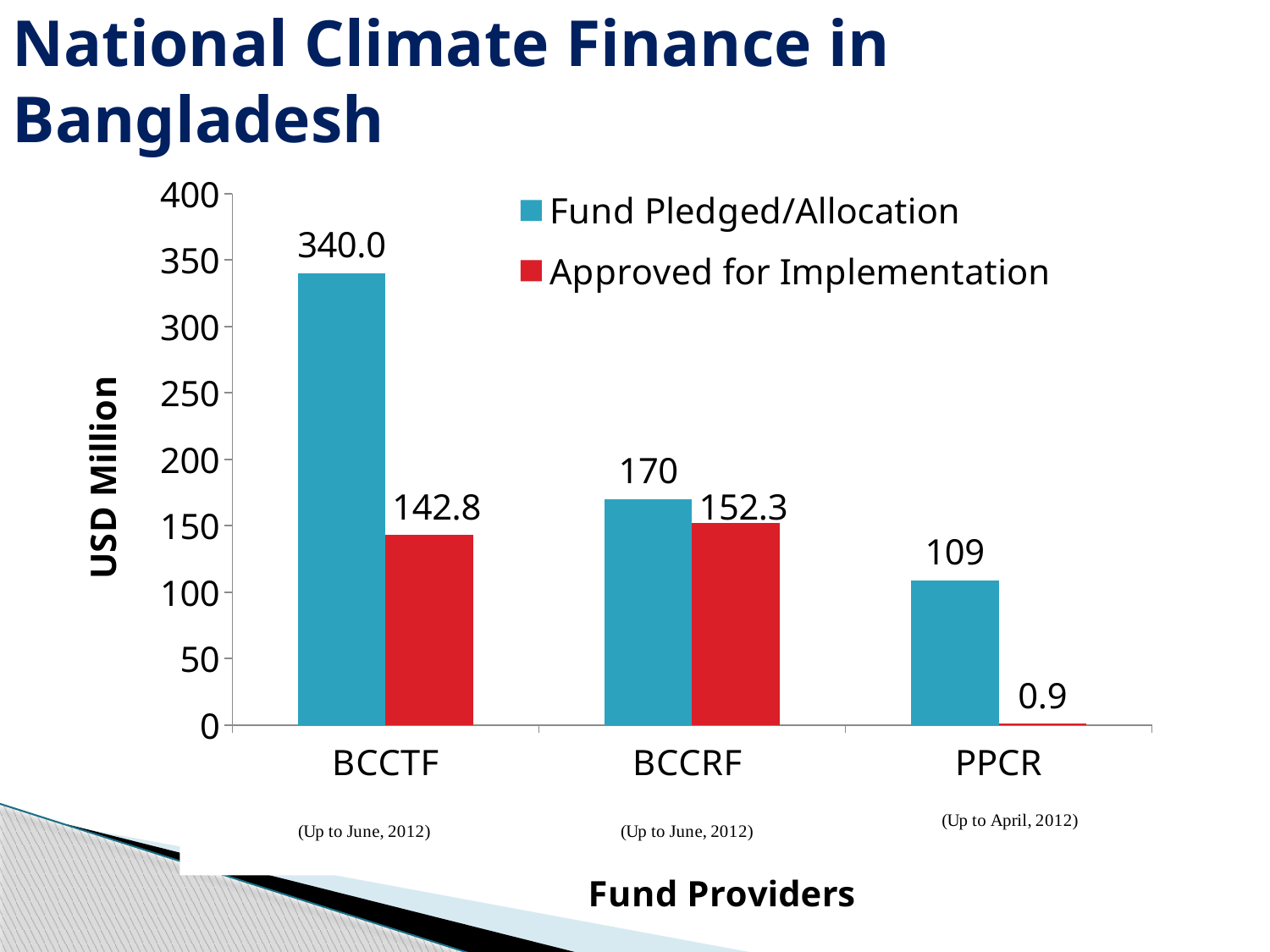
How many series does the legend list? 2 Which fund provider has the highest Fund Pledged/Allocation value? BCCTF What is the label of the y axis? USD Million Which fund provider has the lowest Approved for Implementation value? PPCR What is the difference between Fund Pledged/Allocation and Approved for Implementation for BCCTF? 197.2 What kind of chart is shown on the slide? bar chart Is the Fund Pledged/Allocation value for PPCR greater or less than 150? less How many fund providers are shown on the x axis? 3 For BCCRF, which is larger: Fund Pledged/Allocation or Approved for Implementation? Fund Pledged/Allocation What is the Approved for Implementation value for PPCR? 0.9 What is the Fund Pledged/Allocation value for BCCTF? 340.0 What is the Approved for Implementation value for BCCRF? 152.3